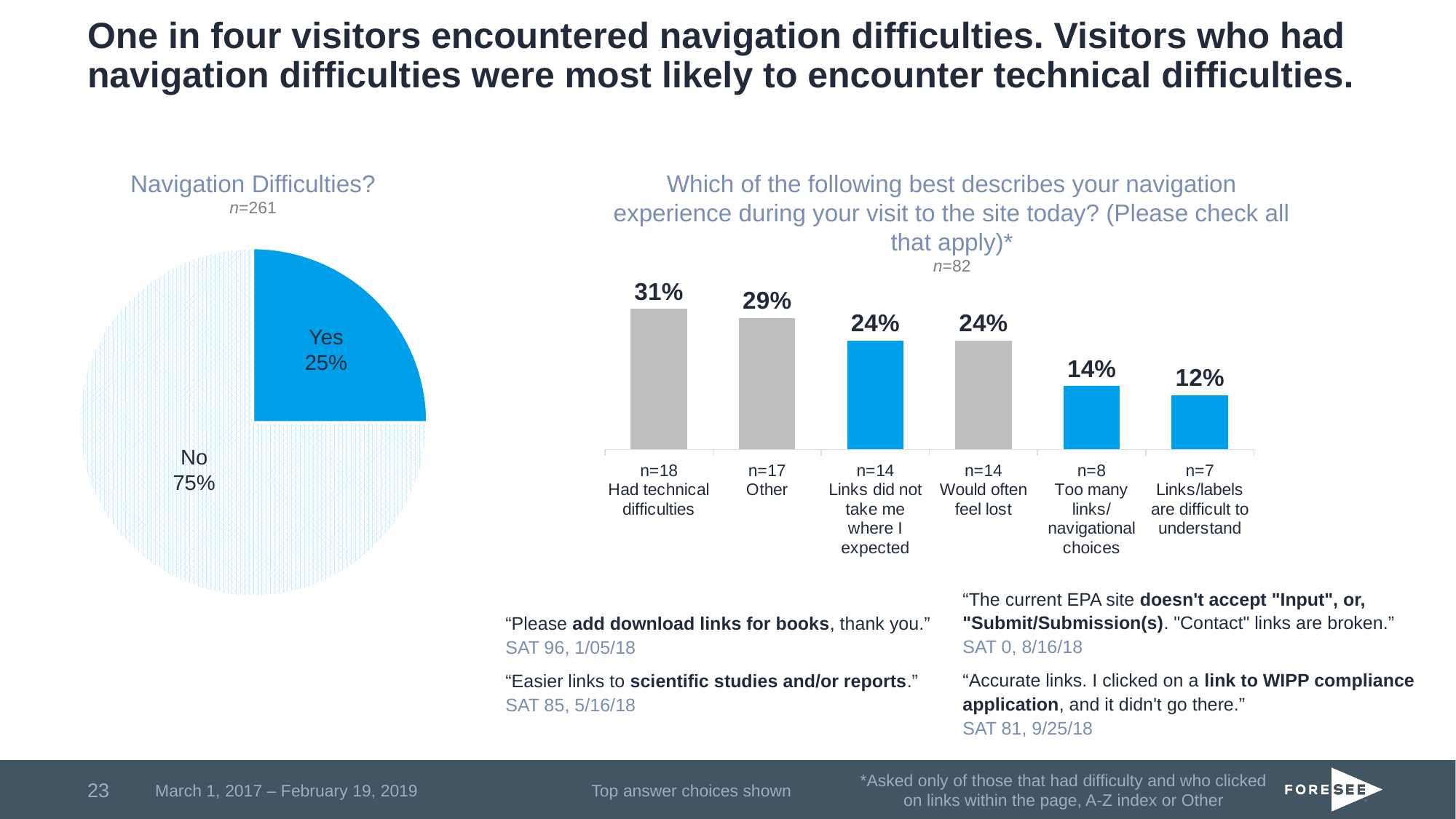
How many categories are shown in the bar chart on the right? 6 In the bar chart on the right, which category has the highest value? Had technical difficulties What kind of chart is the 'Navigation Difficulties?' chart on the left? Pie chart In the bar chart on the right, what is the n value shown for 'Other'? n=17 In the bar chart on the right, what is the difference between 'Had technical difficulties' and 'Other'? 2% In the bar chart on the right, which category has the lowest value? Links/labels are difficult to understand In the bar chart on the right, what is the value for 'Too many links/navigational choices'? 14% In the bar chart on the right, what is the value for 'Had technical difficulties'? 31% What kind of chart is the 'Which of the following best describes your navigation experience' chart on the right? Bar chart In the 'Navigation Difficulties?' pie chart, what percentage of visitors answered Yes? 25% In the bar chart on the right, which is larger: 'Would often feel lost' or 'Links/labels are difficult to understand'? Would often feel lost In the 'Navigation Difficulties?' pie chart, what percentage of visitors answered No? 75%